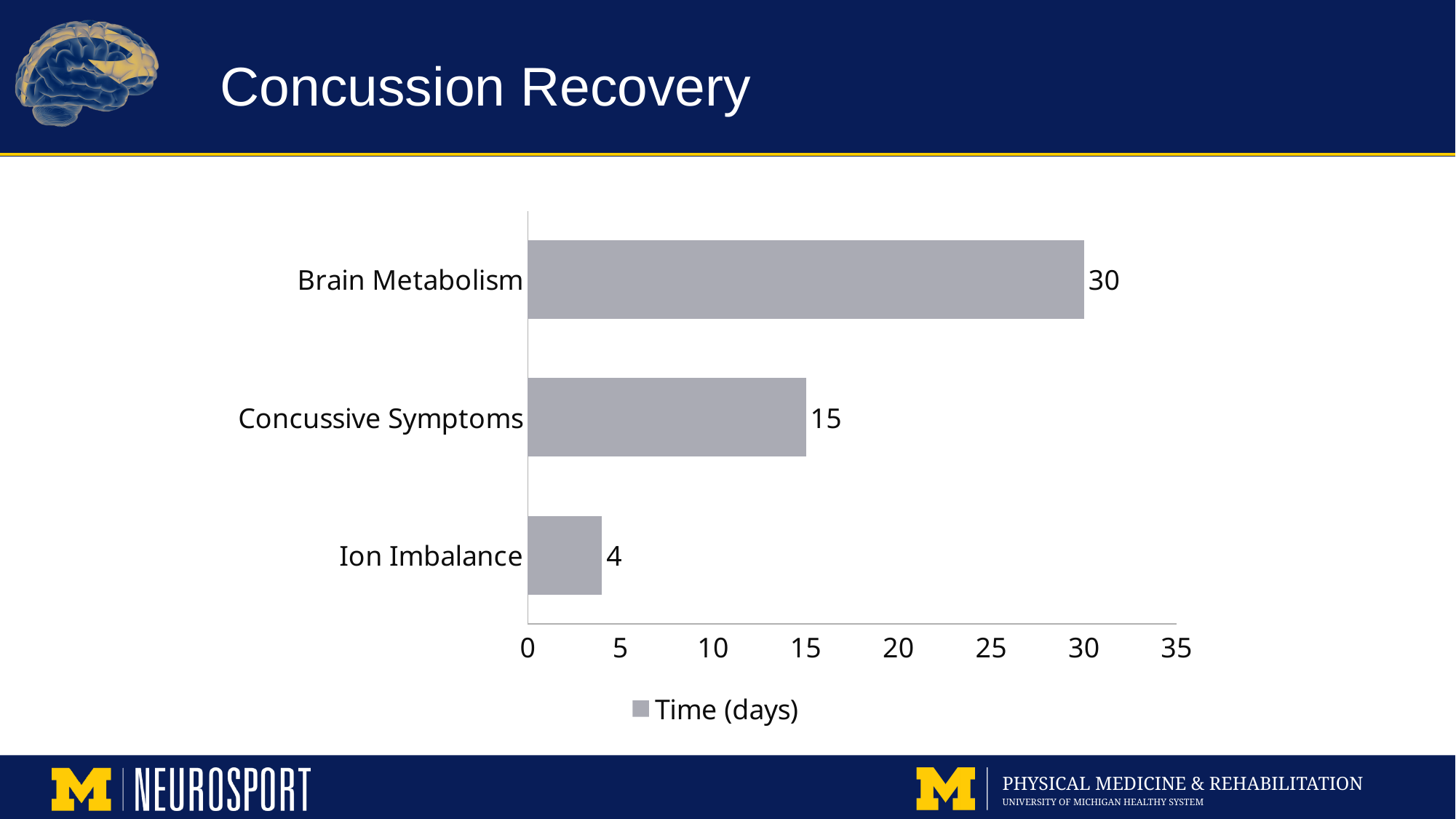
What is the value for Ion Imbalance? 4 Which category has the highest value? Brain Metabolism What series does the legend list? Time (days) What kind of chart is shown on the slide? bar chart How many categories are shown in the chart? 3 What is the difference between the values for Brain Metabolism and Concussive Symptoms? 15 What is the value for Concussive Symptoms? 15 Which is larger, the value for Concussive Symptoms or the value for Ion Imbalance? Concussive Symptoms Is the value for Brain Metabolism greater or less than 25? greater What is the difference between the values for Concussive Symptoms and Ion Imbalance? 11 What is the value for Brain Metabolism? 30 Which category has the lowest value? Ion Imbalance